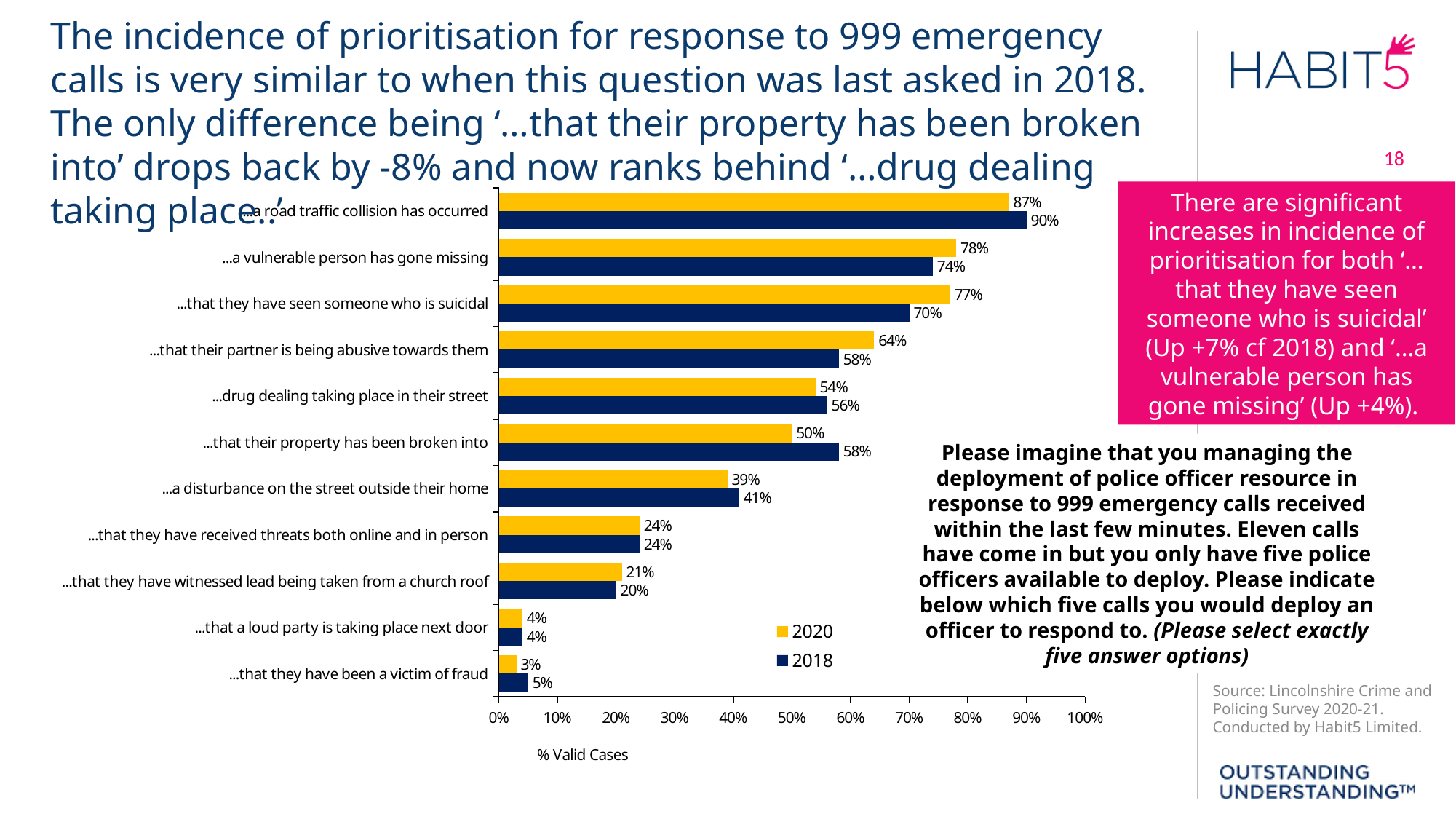
What is the x-axis label of the chart? % Valid Cases How many categories are shown in the chart? 11 What is the 2018 value for '...that they have seen someone who is suicidal'? 70% Which category has the highest 2020 value? ...a road traffic collision has occurred How many series does the legend list? 2 What is the difference between the 2020 and 2018 values for '...that they have seen someone who is suicidal'? 7% Which is larger for '...a vulnerable person has gone missing': the 2020 value or the 2018 value? 2020 What is the difference between the 2018 and 2020 values for '...that their property has been broken into'? 8% What is the 2020 value for '...that their property has been broken into'? 50% What is the 2020 value for '...drug dealing taking place in their street'? 54% What type of chart is shown on the slide? Bar chart Which category has the lowest 2018 value? ...that a loud party is taking place next door